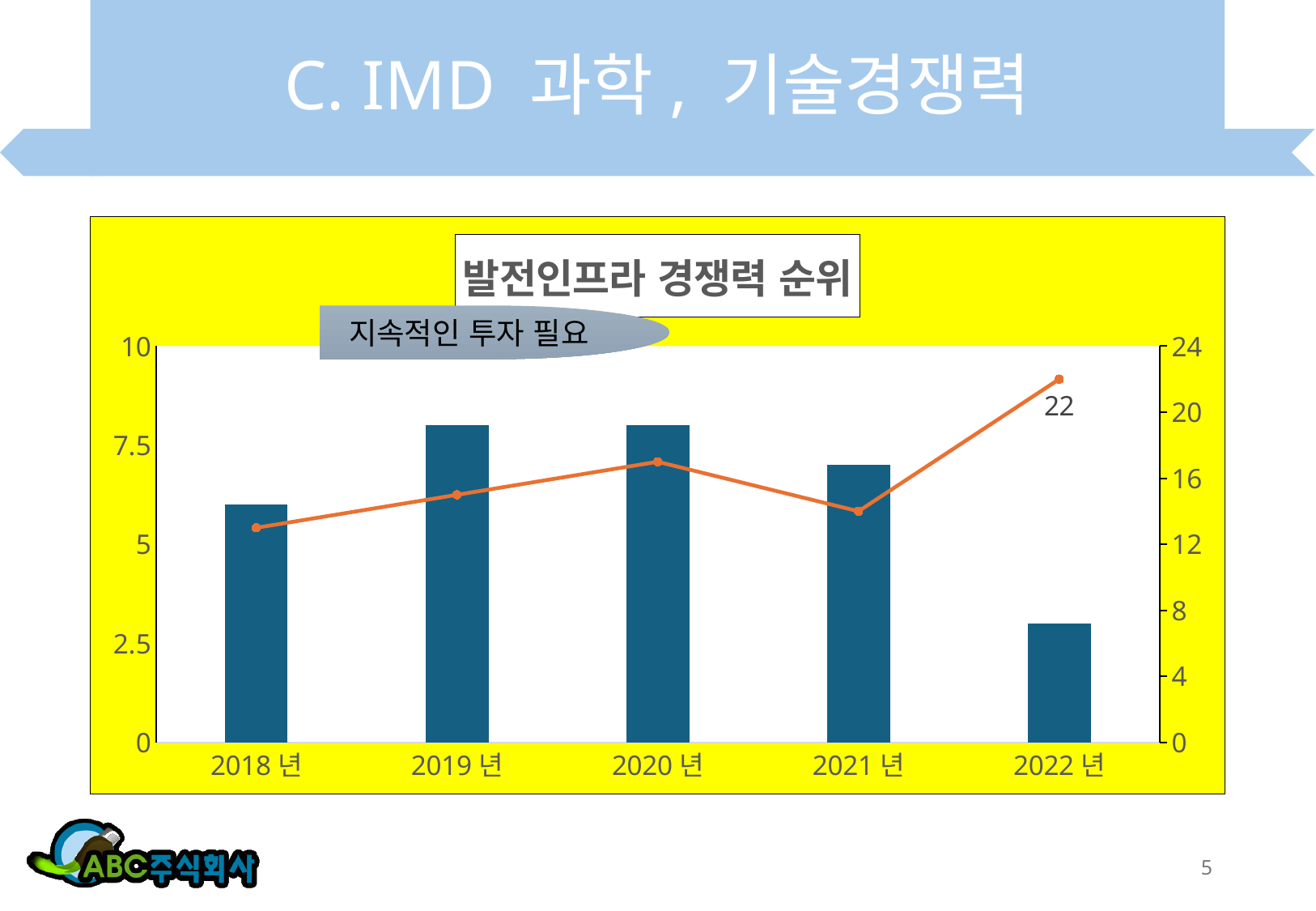
What value is labelled on the line at 2022 년? 22 Which year has the highest point on the line? 2022 년 Is the bar value for 2019 년 greater or less than 7.5? greater What is the title of the chart? 발전인프라 경쟁력 순위 Is the bar value for 2022 년 greater or less than 5? less Which year has the lowest bar? 2022 년 Is the bar value for 2018 년 greater or less than 5? greater What kind of chart is this? Combined bar and line chart How many years are shown on the x axis? 5 Does the line rise or fall from 2021 년 to 2022 년? rise Which bar is taller, 2021 년 or 2022 년? 2021 년